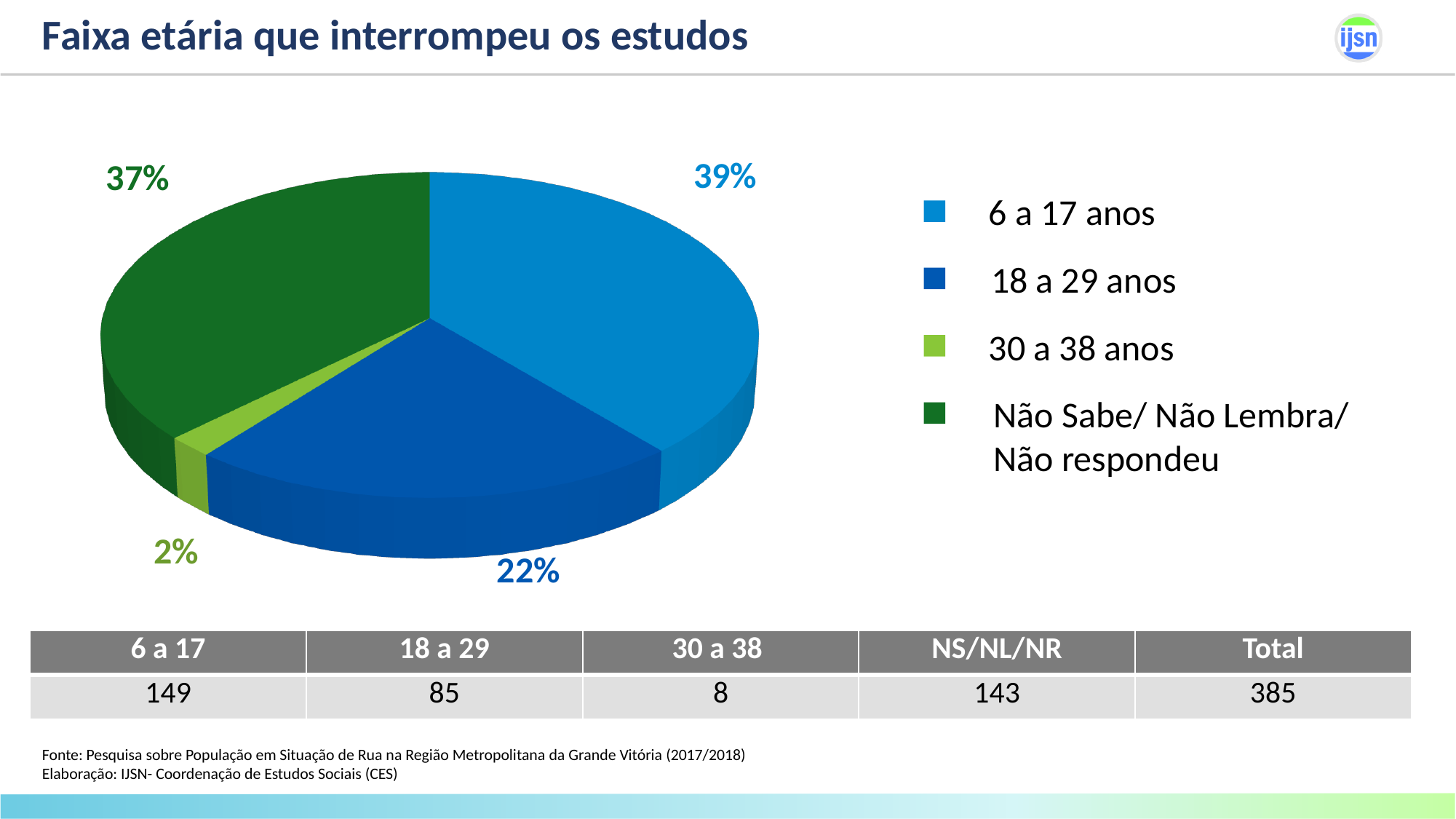
How many categories does the pie chart have? 4 What is the difference in percentage points between the '6 a 17 anos' slice and the '18 a 29 anos' slice? 17 What colour is the slice for '30 a 38 anos'? light green What percentage of the pie corresponds to 'Não Sabe/ Não Lembra/ Não respondeu'? 37% What is the title of the slide containing the pie chart? Faixa etária que interrompeu os estudos What kind of chart is shown on the slide? pie chart What percentage of the pie corresponds to '6 a 17 anos'? 39% Which slice is larger: '18 a 29 anos' or 'Não Sabe/ Não Lembra/ Não respondeu'? Não Sabe/ Não Lembra/ Não respondeu Which category has the smallest slice of the pie? 30 a 38 anos What percentage of the pie corresponds to '30 a 38 anos'? 2% Which category has the largest slice of the pie? 6 a 17 anos What percentage of the pie corresponds to '18 a 29 anos'? 22%